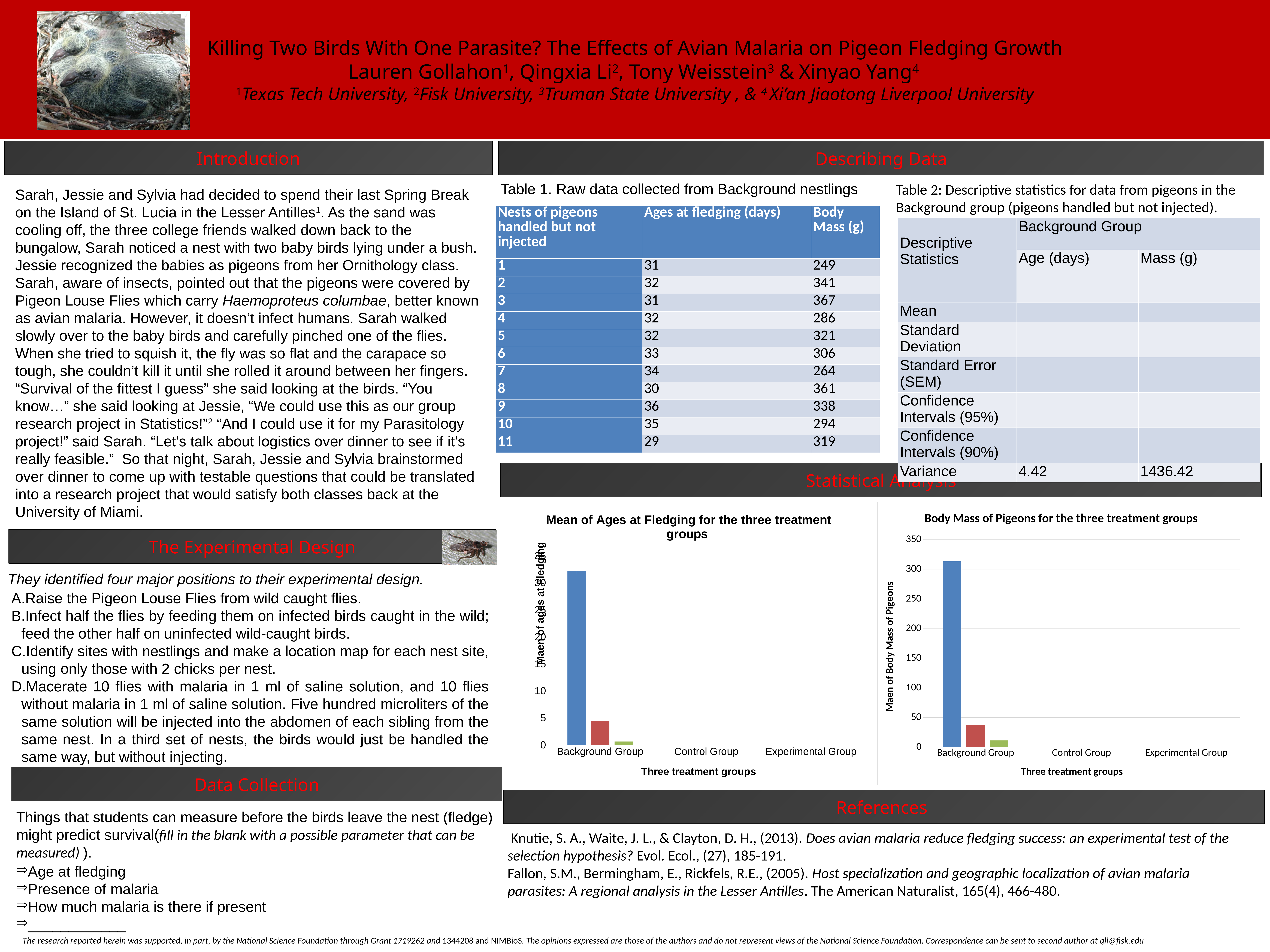
How many treatment groups are labelled on the x axis of the 'Body Mass of Pigeons' chart? 3 How many treatment groups are labelled on the x axis of the 'Mean of Ages at Fledging' chart? 3 What is the x-axis title of the 'Body Mass of Pigeons for the three treatment groups' chart? Three treatment groups In the 'Body Mass of Pigeons' chart, do the bar heights rise or fall from left to right? fall In the 'Mean of Ages at Fledging' chart, which coloured bar is the tallest? blue In the 'Mean of Ages at Fledging' chart, is the tallest (blue) bar greater or less than 30? greater What kind of chart is the 'Body Mass of Pigeons for the three treatment groups' chart? bar chart What kind of chart is the 'Mean of Ages at Fledging for the three treatment groups' chart? bar chart In the 'Body Mass of Pigeons' chart, which coloured bar is the shortest? green In the 'Mean of Ages at Fledging' chart, is the red bar greater or less than 10? less In the 'Body Mass of Pigeons' chart, is the red bar greater or less than 50? less